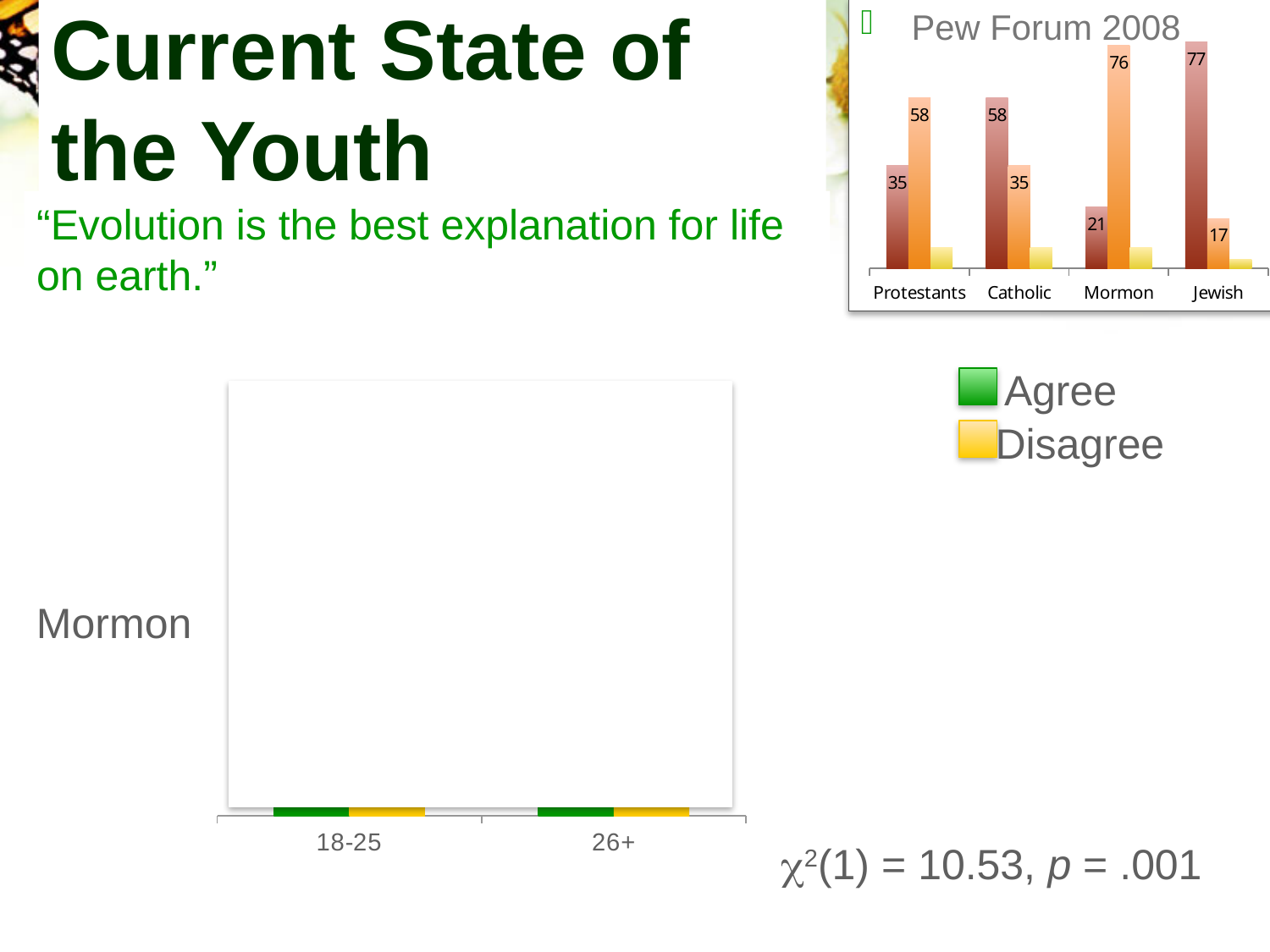
In the Pew Forum 2008 chart, what is the value of the dark red bar for Jewish? 77 In the Pew Forum 2008 chart, what is the value of the orange bar for Mormon? 76 In the Pew Forum 2008 chart, what is the value of the orange bar for Catholic? 35 In the Pew Forum 2008 chart, what is the value of the dark red bar for Protestants? 35 In the Pew Forum 2008 chart, which is larger for Protestants: the dark red bar or the orange bar? the orange bar What are the two legend entries shown for the Mormon chart at the bottom left? Agree and Disagree How many categories are shown on the x axis of the Pew Forum 2008 chart? 4 In the Pew Forum 2008 chart, which category has the lowest orange bar? Jewish In the Pew Forum 2008 chart, which category has the highest dark red bar? Jewish In the Pew Forum 2008 chart, what is the difference between the orange bar and the dark red bar for Mormon? 55 What kind of chart is the Pew Forum 2008 chart? bar chart How many categories are shown on the x axis of the Mormon chart at the bottom left? 2